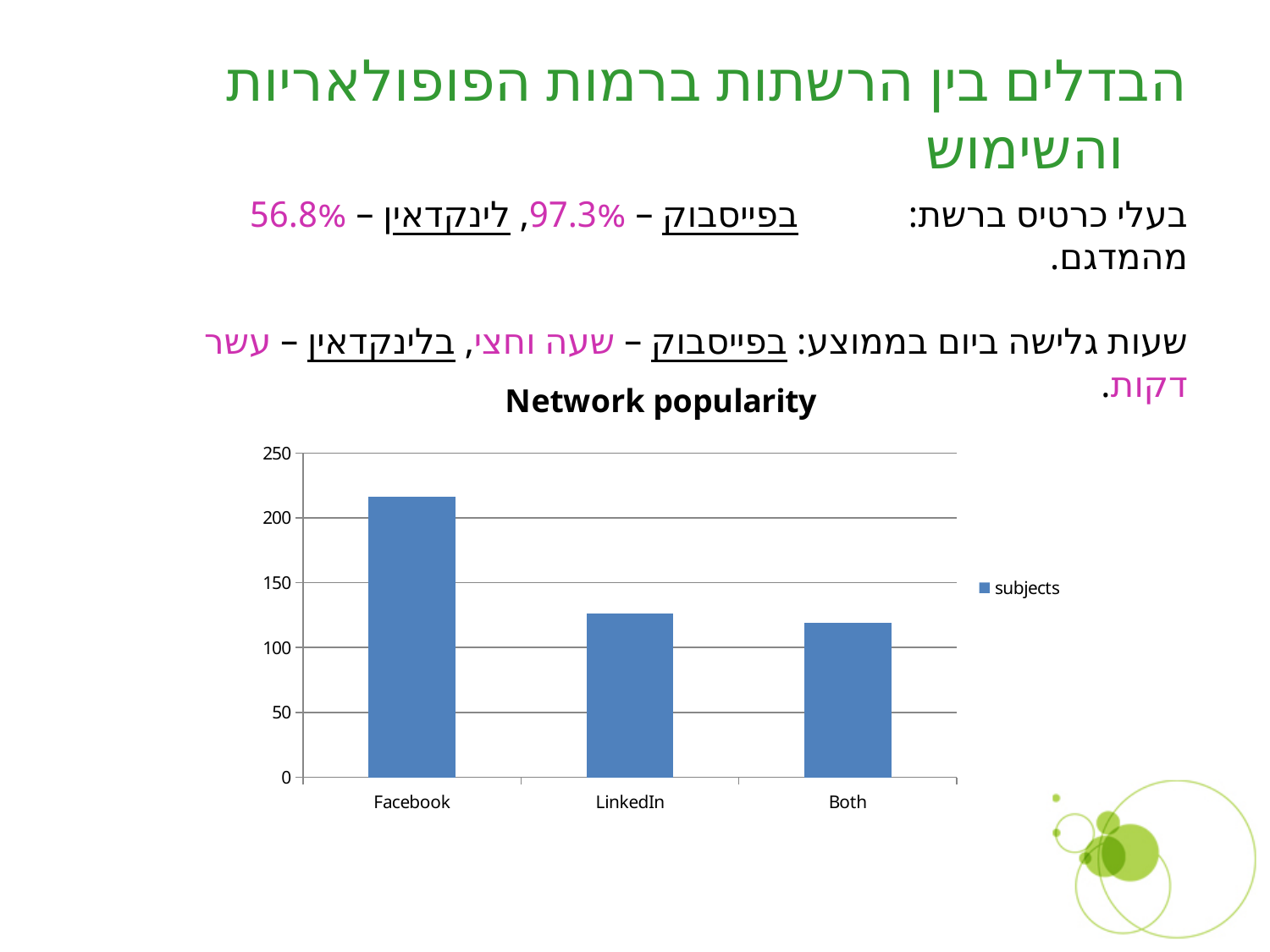
How many categories are shown on the x axis of the chart? 3 Is the value for Facebook greater or less than 200? greater Is the value for LinkedIn greater or less than 100? greater How many series does the chart's legend list? 1 Is the value for LinkedIn greater or less than 150? less What kind of chart is shown on the slide? bar chart What is the title of the chart? Network popularity Which category has the highest value in the chart? Facebook What is the name of the series shown in the chart's legend? subjects Which is larger, the value for Facebook or the value for LinkedIn? Facebook